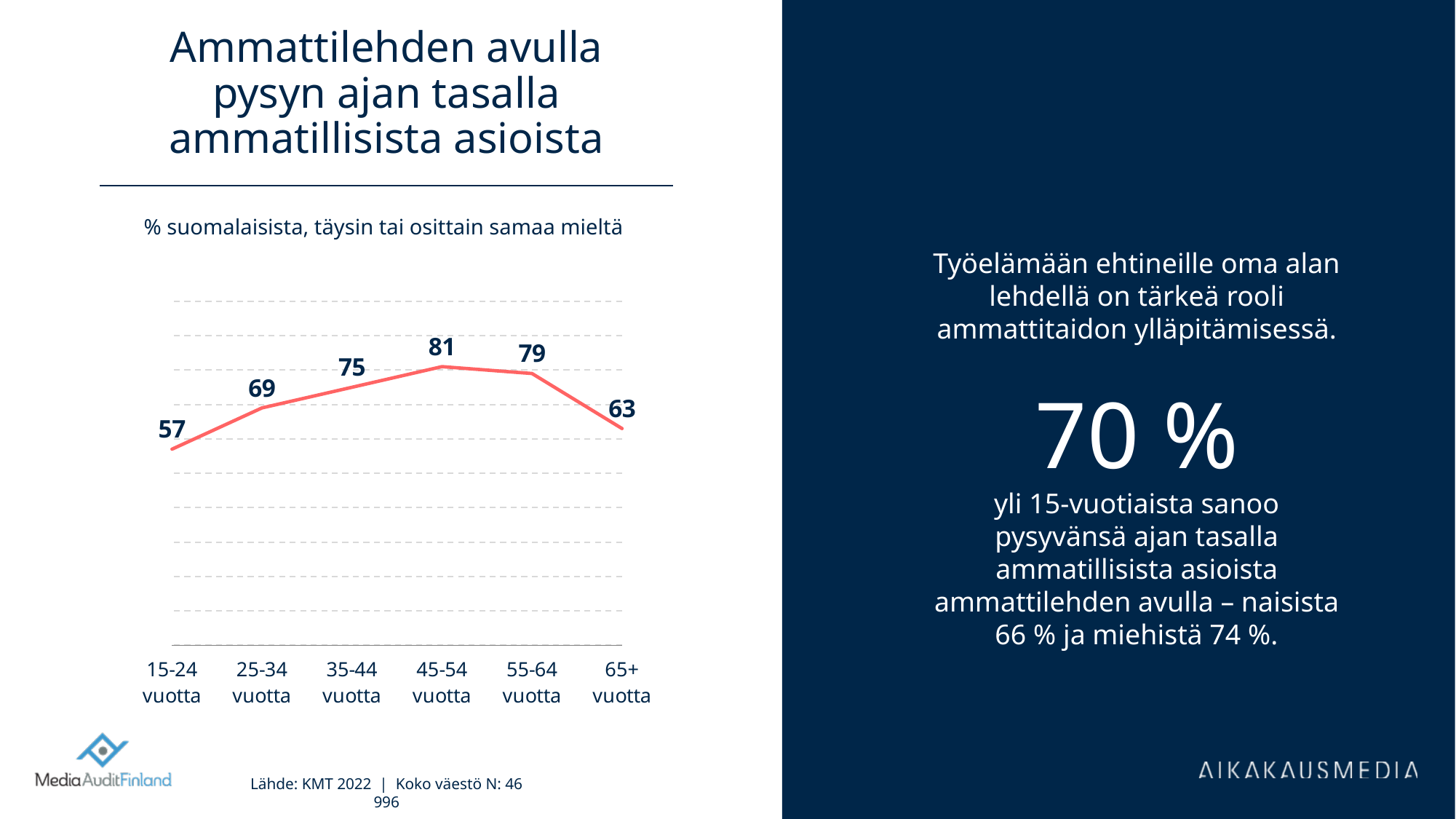
What is the value for the 45-54 vuotta age group? 81 What is the difference between the values for 55-64 vuotta and 65+ vuotta? 16 Which is larger, the value for 25-34 vuotta or the value for 35-44 vuotta? 35-44 vuotta What is the difference between the values for 45-54 vuotta and 15-24 vuotta? 24 What is the value for the 15-24 vuotta age group? 57 Which age group has the highest value? 45-54 vuotta Which age group has the lowest value? 15-24 vuotta What is the subtitle shown above the chart? % suomalaisista, täysin tai osittain samaa mieltä What kind of chart is shown on the slide? Line chart Do the values rise or fall from 15-24 vuotta to 45-54 vuotta? Rise What is the value for the 65+ vuotta age group? 63 How many age groups are plotted on the chart? 6